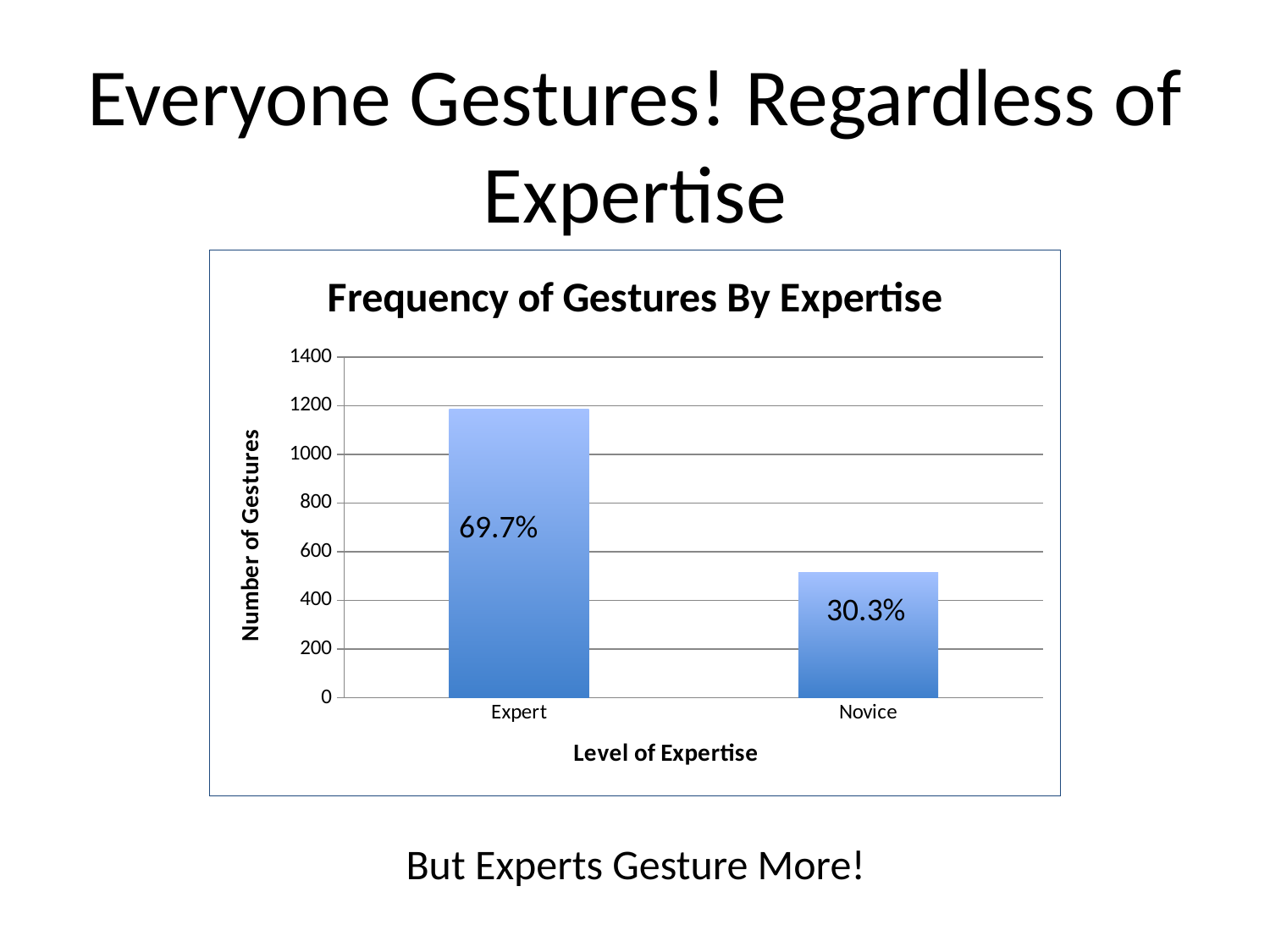
What is the difference between the percentage labels on the Expert and Novice bars? 39.4% How many categories are shown on the x axis of the chart? 2 Which level of expertise has the highest number of gestures? Expert What percentage label is printed on the Expert bar? 69.7% Is the number of gestures for Novice greater or less than 400? greater Which level of expertise has the lowest number of gestures? Novice What is the title of the chart? Frequency of Gestures By Expertise Is the number of gestures for Expert greater or less than 1000? greater What percentage label is printed on the Novice bar? 30.3% What is the label of the y axis of the chart? Number of Gestures Is the number of gestures for Novice greater or less than 600? less What type of chart is shown on the slide? bar chart